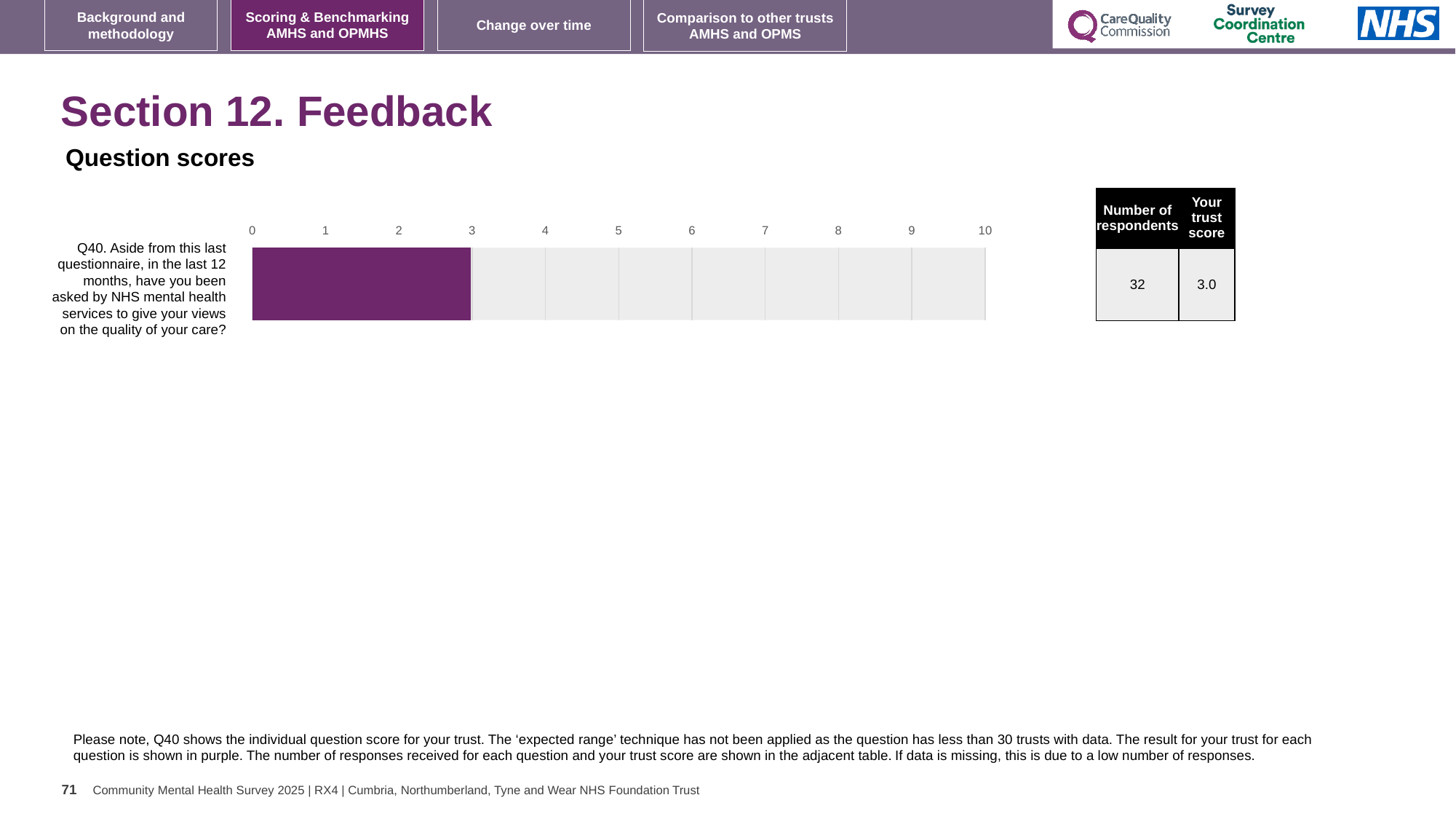
Is the value for Q40 greater or less than 2? greater Which axis tick does the Q40 bar end at? 3 What kind of chart is used to show the Q40 question score? bar chart How many questions (bars) are plotted in the chart? 1 What is the maximum value shown on the chart's axis? 10 How many respondents answered Q40 according to the table? 32 What is the trust score for Q40 shown on the slide? 3.0 Is the value for Q40 greater or less than 5? less What colour is the bar showing the trust's result for Q40? purple